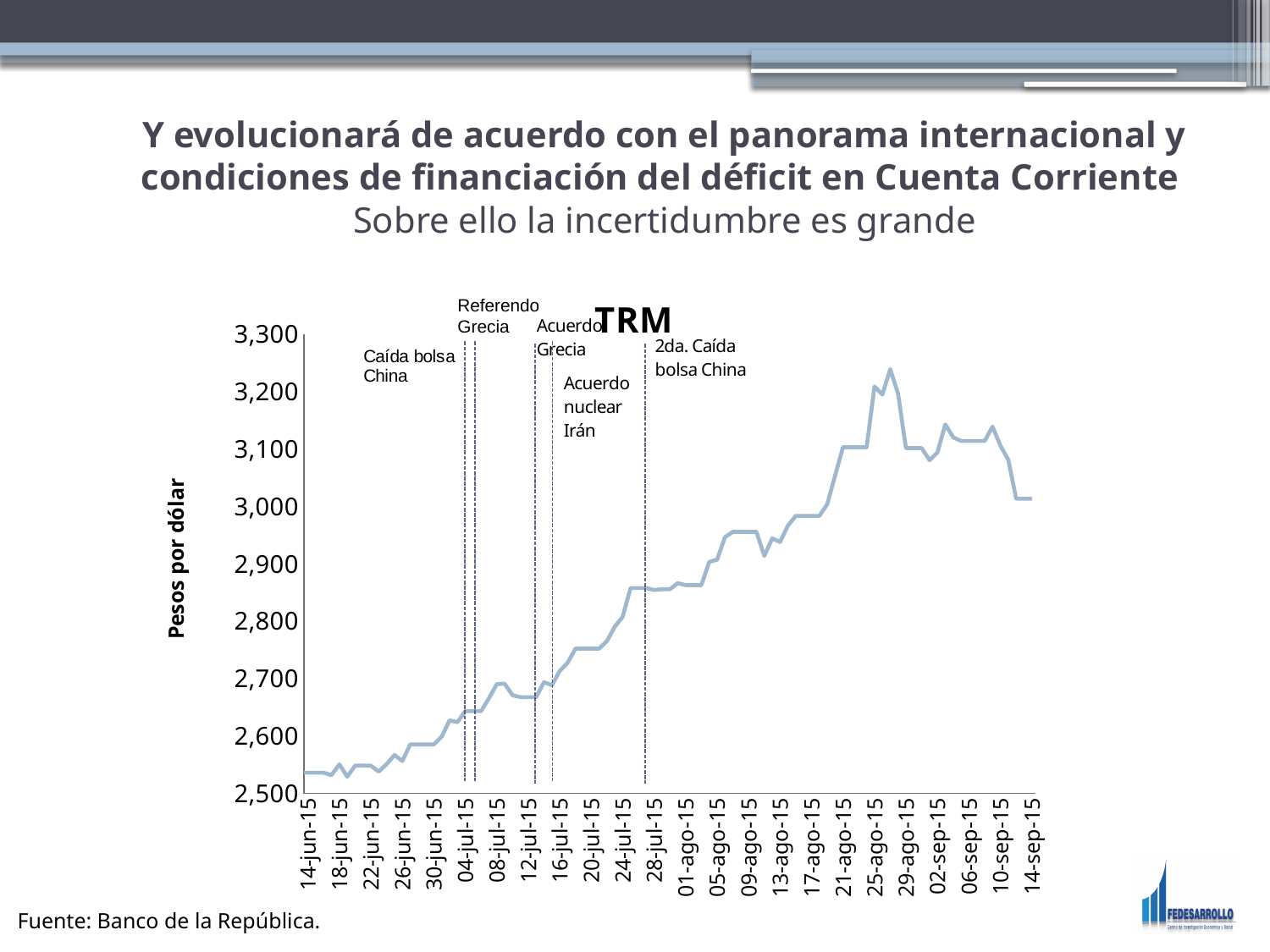
Is the value for 21-ago-15 greater or less than 3,000? greater What is the title of the chart? TRM Is the value for 14-sep-15 greater or less than 2,900? greater Is the value for 14-jun-15 greater or less than 2,600? less What kind of chart is shown on the slide? line chart Which is larger, the value for 28-jul-15 or the value for 04-jul-15? 28-jul-15 Overall, do the values rise or fall from 14-jun-15 to 14-sep-15? rise Which is larger, the value for 14-jun-15 or the value for 14-sep-15? 14-sep-15 What is the label of the vertical axis of the chart? Pesos por dólar